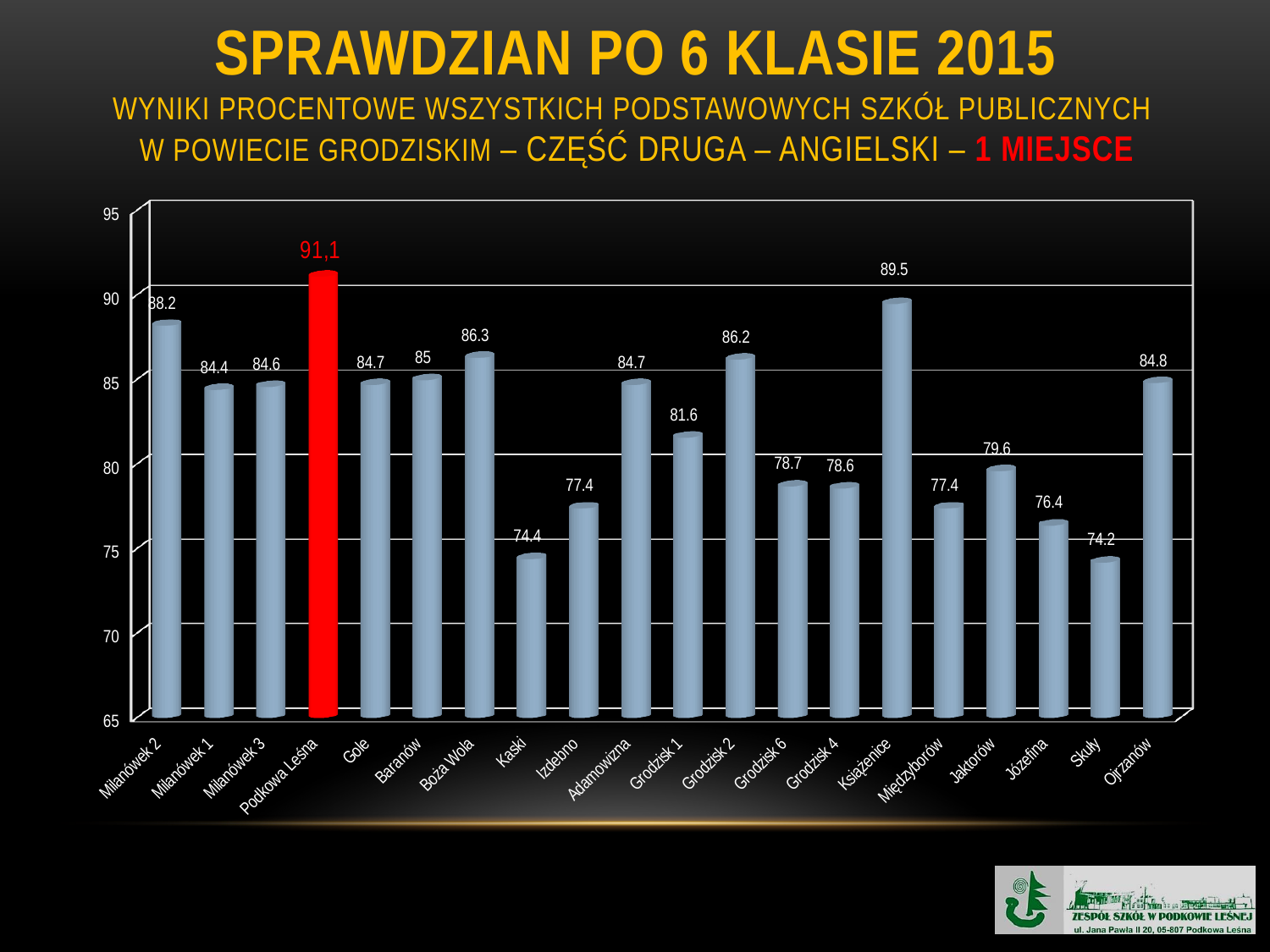
Is the value for Jaktorów greater or less than 80? less What is the value for Grodzisk 1? 81.6 What is the value for Podkowa Leśna? 91,1 Which school's bar is highlighted in red? Podkowa Leśna What is the difference between the values for Boża Wola and Kaski? 11.9 Which is larger, the value for Książenice or the value for Milanówek 2? Książenice Which school has the highest value? Podkowa Leśna How many schools are shown on the x axis? 20 What is the difference between the values for Milanówek 2 and Milanówek 1? 3.8 What is the value for Skuły? 74.2 What is the value for Książenice? 89.5 Which school has the lowest value? Skuły